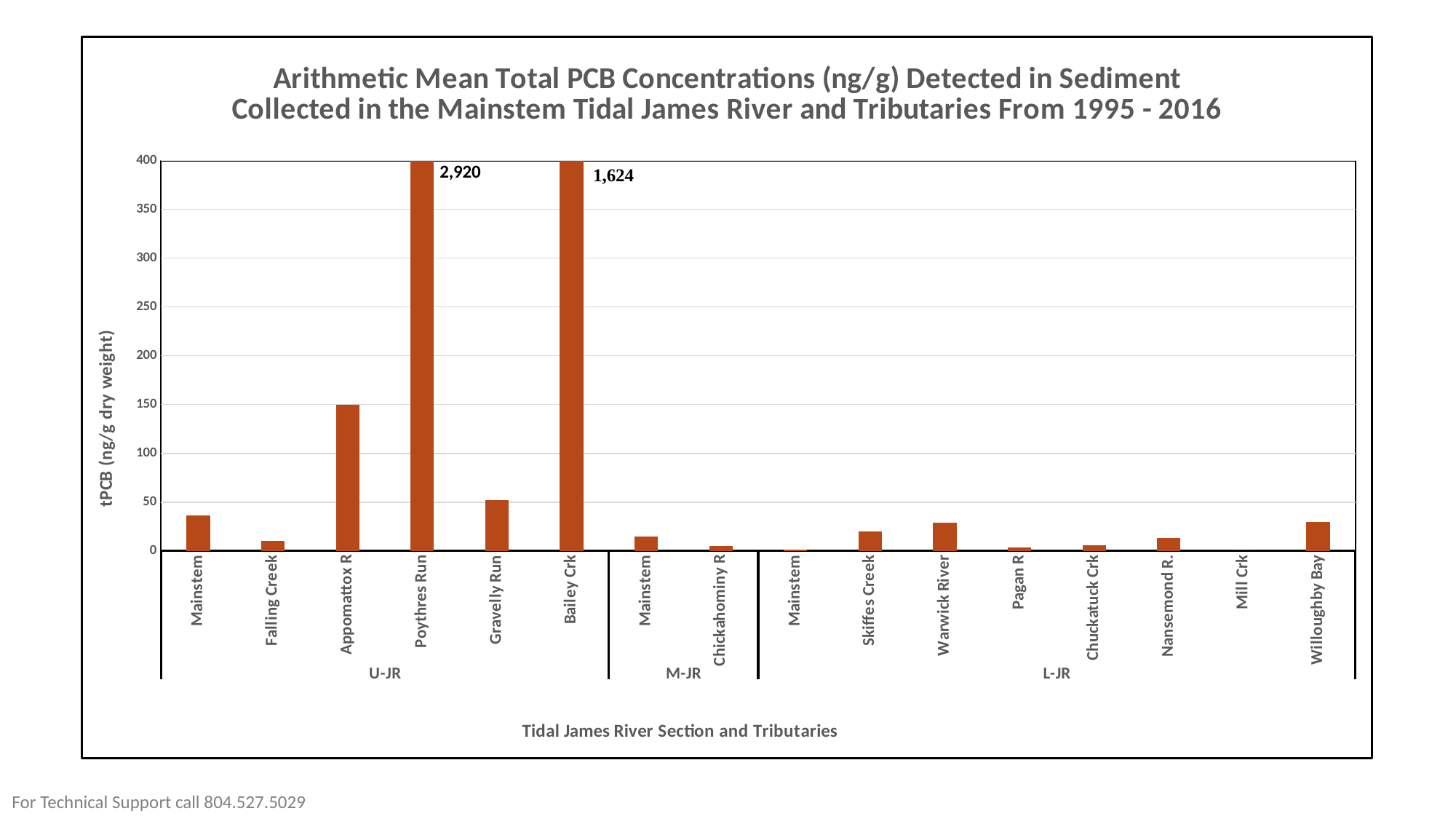
Is the value for Gravelly Run greater or less than 100? less What kind of chart is shown? bar chart Which category has the highest value? Poythres Run What is the value for Poythres Run? 2,920 What is the y-axis title? tPCB (ng/g dry weight) How many categories are plotted on the x axis? 16 Is the value for Appomattox R greater or less than 100? greater What is the value for Bailey Crk? 1,624 How many categories are in the L-JR section? 8 Which is larger, the value for Poythres Run or the value for Bailey Crk? Poythres Run What is the difference between the values for Poythres Run and Bailey Crk? 1,296 Is the value for Warwick River greater or less than 50? less